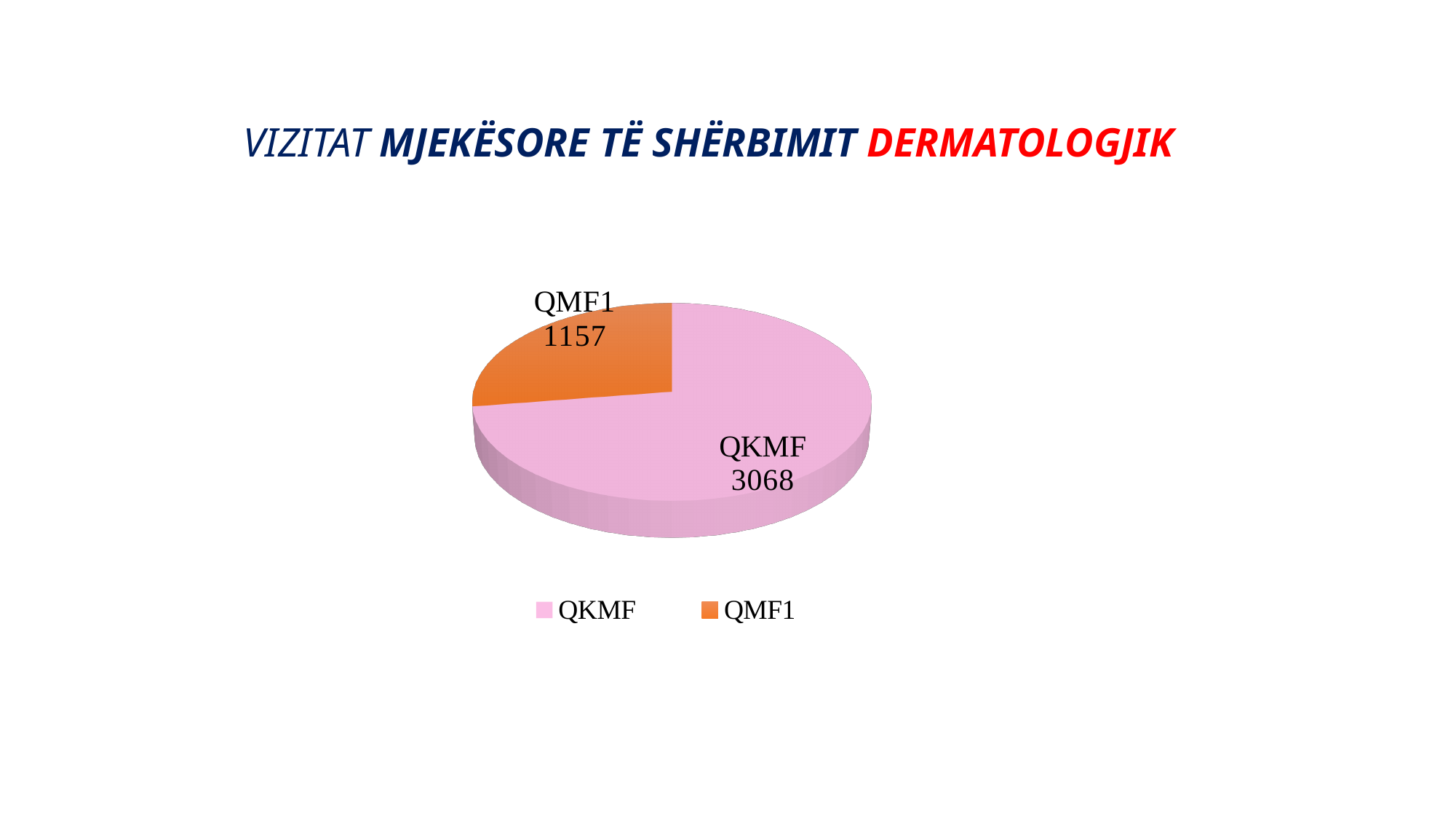
What is the value for QKMF? 3068 What colour is the QKMF slice? pink Which is larger, the value for QKMF or the value for QMF1? QKMF What kind of chart is shown on the slide? pie chart What is the difference between the values for QKMF and QMF1? 1911 How many entries does the legend list? 2 What is the value for QMF1? 1157 What colour is the QMF1 slice? orange Which category has the highest value? QKMF Which category has the lowest value? QMF1 What is the total of all slices in the pie chart? 4225 How many slices does the pie chart have? 2